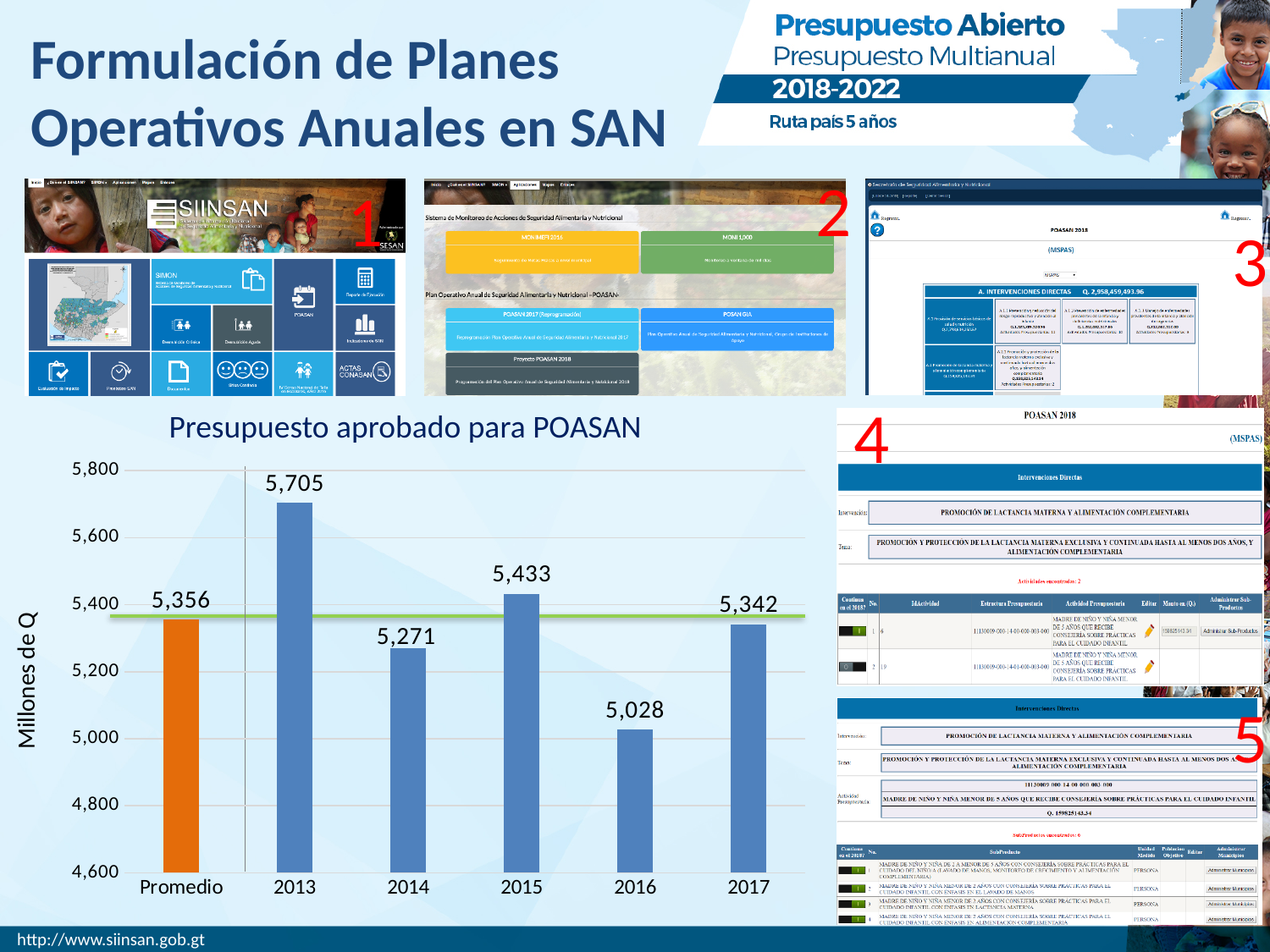
What is the label of the vertical axis of the chart? Millones de Q Which year has the lowest approved budget in the chart? 2016 What is the value for 2013 in the chart? 5,705 What type of chart is used to show the approved budget for POASAN? bar chart What is the value for 2016 in the chart? 5,028 What is the value for Promedio in the chart? 5,356 What is the difference between the values for 2013 and 2016? 677 Which is larger, the value for 2015 or the value for 2017? 2015 What is the title of the chart on the slide? Presupuesto aprobado para POASAN What is the difference between the value for 2014 and the Promedio value? 85 How many bars are shown in the chart? 6 Which year has the highest approved budget in the chart? 2013